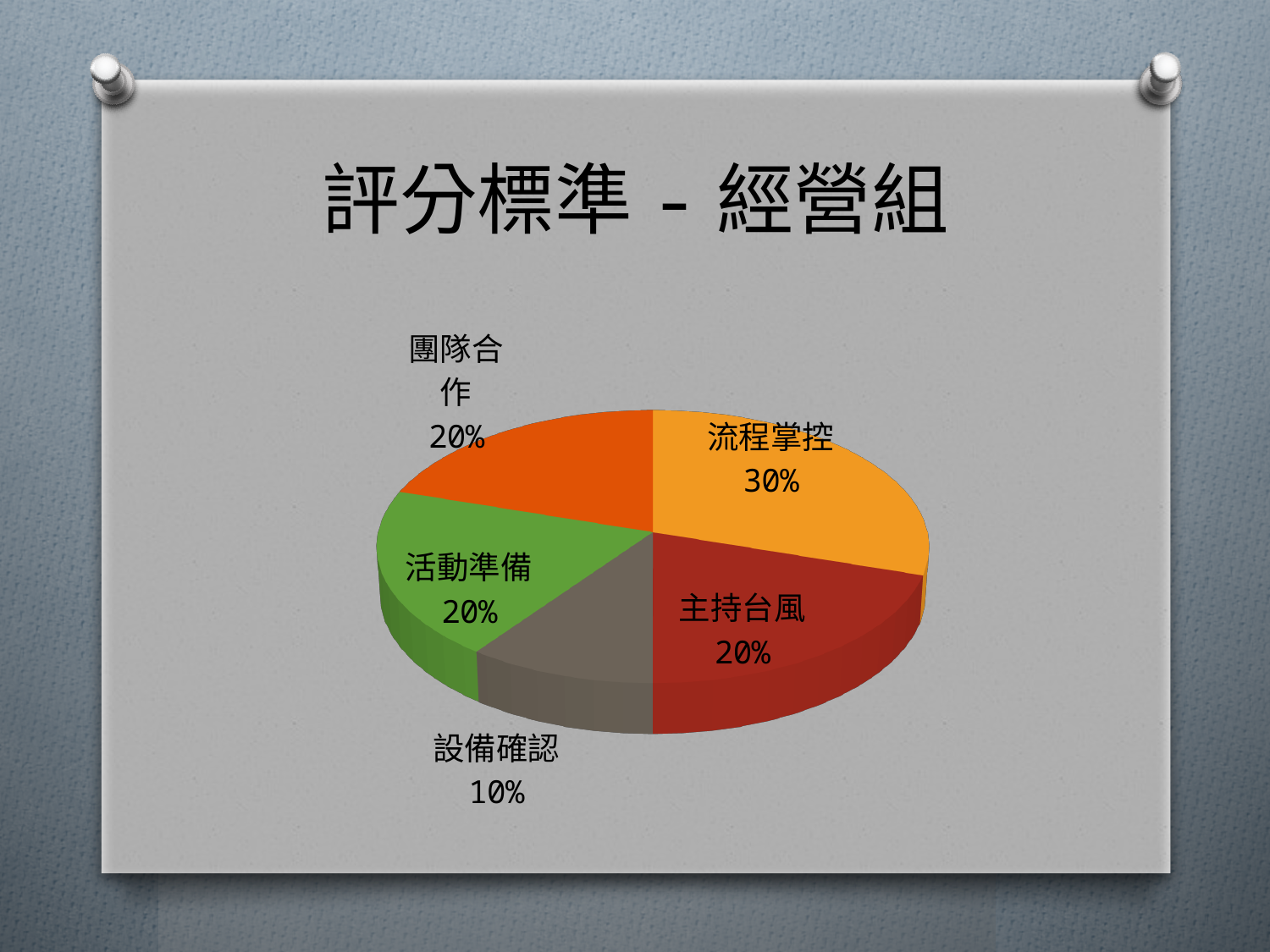
What is the difference between the values for 流程掌控 and 設備確認? 20% What is the value for 設備確認? 10% What kind of chart is shown on the slide? pie chart Which category has the smallest share of the pie? 設備確認 What is the value for 團隊合作? 20% What is the value for 主持台風? 20% What is the title of the slide containing the chart? 評分標準 - 經營組 What is the value for 流程掌控? 30% What colour is the 主持台風 slice? red Which is larger, the value for 流程掌控 or the value for 活動準備? 流程掌控 How many categories are shown in the pie chart? 5 Which category has the largest share of the pie? 流程掌控